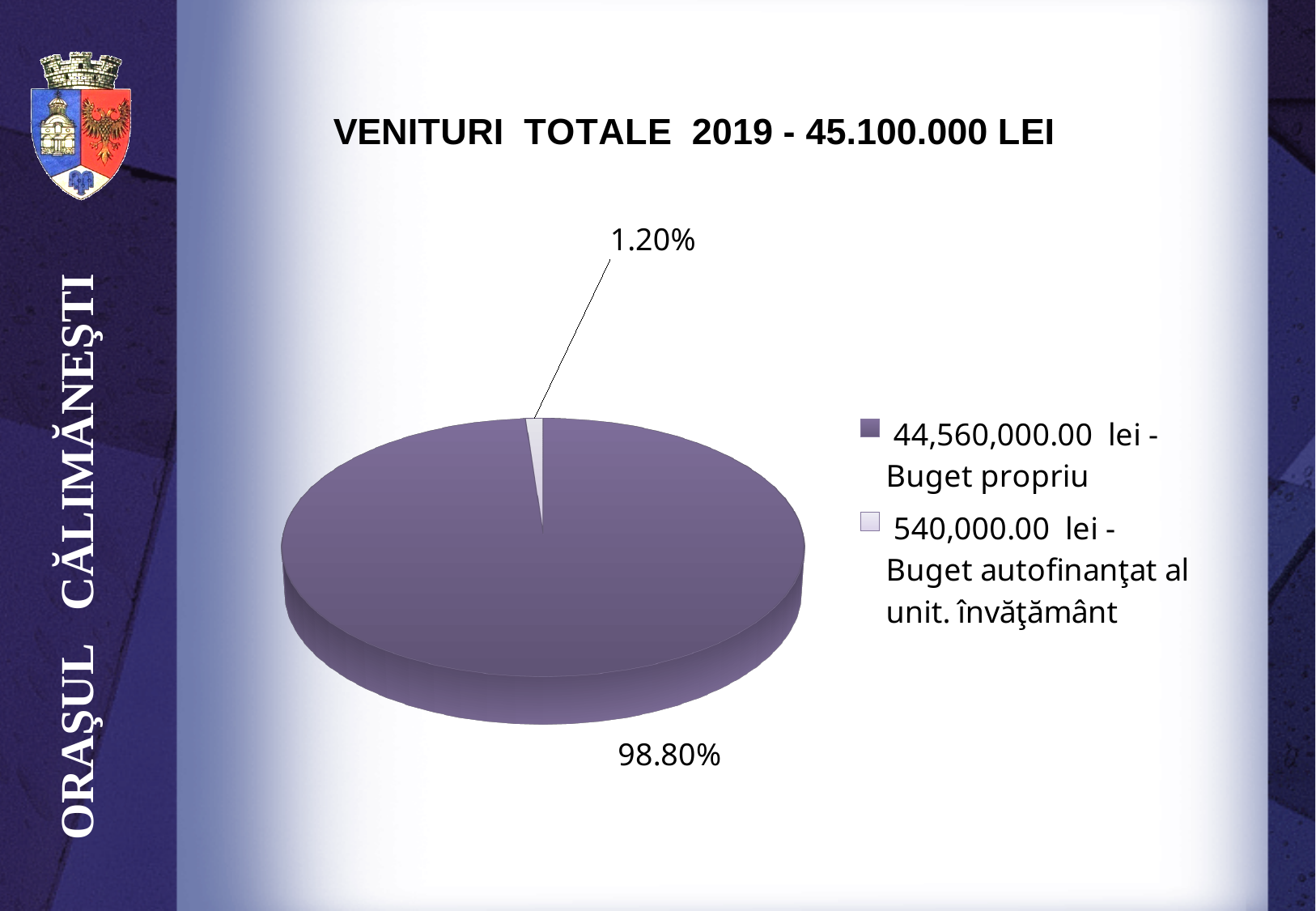
What is the difference in percentage points between the two slices of the pie? 97.60% What share of the pie does "Buget autofinanţat al unit. învăţământ" represent? 1.20% What is the value shown in the legend for "Buget propriu"? 44,560,000.00 lei What is the value shown in the legend for "Buget autofinanţat al unit. învăţământ"? 540,000.00 lei Which slice of the pie is the largest? Buget propriu Which is larger, the share for "Buget propriu" or the share for "Buget autofinanţat al unit. învăţământ"? Buget propriu Which slice of the pie is the smallest? Buget autofinanţat al unit. învăţământ What is the title of the chart? VENITURI TOTALE 2019 - 45.100.000 LEI What kind of chart is shown on the slide? pie chart How many entries does the legend list? 2 What share of the pie does "Buget propriu" represent? 98.80% How many slices does the pie chart have? 2